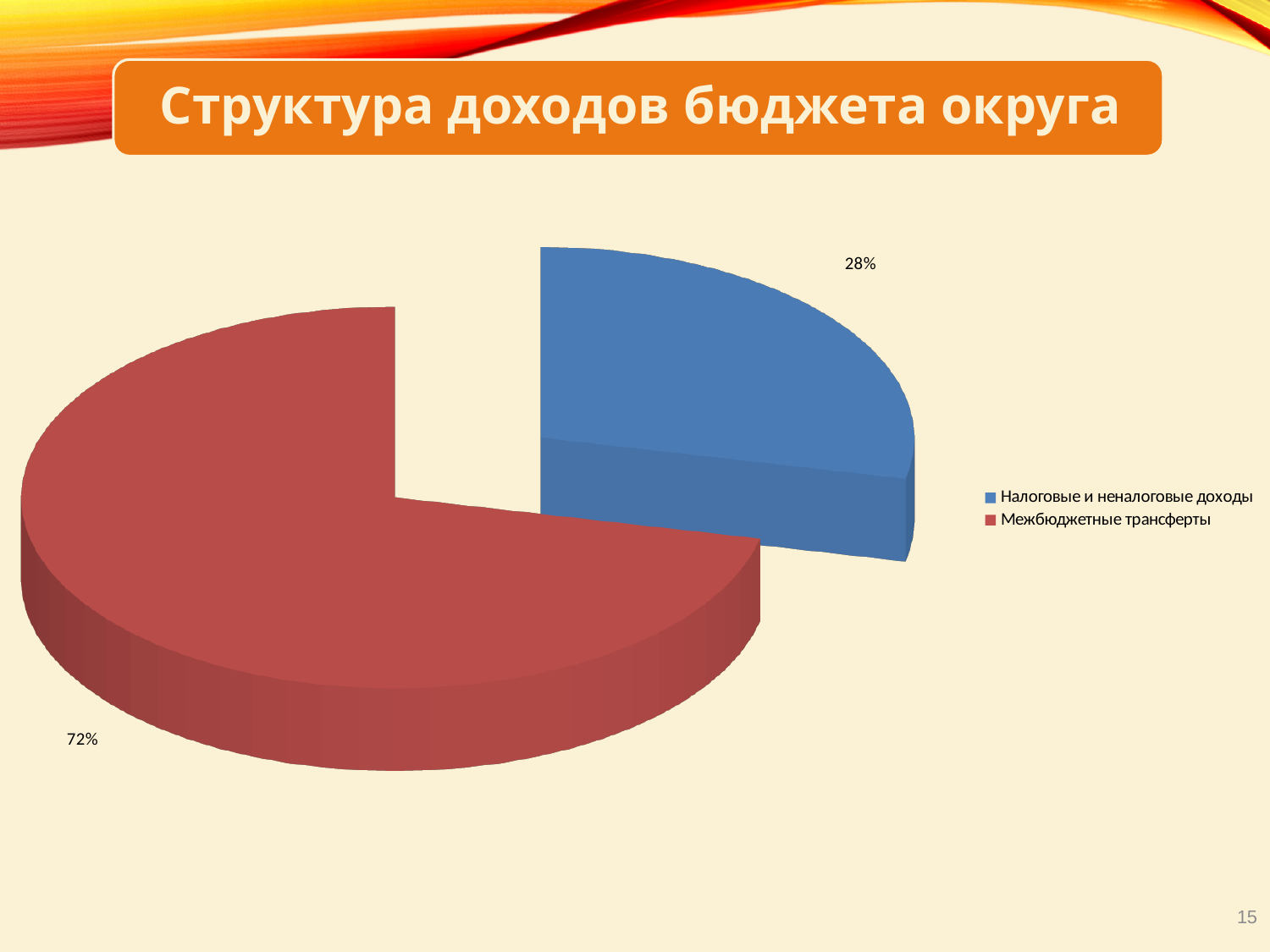
Which category has the largest slice of the pie? Межбюджетные трансферты What is the difference in percentage points between Межбюджетные трансферты and Налоговые и неналоговые доходы? 44 What is the title of the slide? Структура доходов бюджета округа What share of the pie does Налоговые и неналоговые доходы represent? 28% Which is larger: the slice for Налоговые и неналоговые доходы or the slice for Межбюджетные трансферты? Межбюджетные трансферты Which category has the smallest slice of the pie? Налоговые и неналоговые доходы How many slices does the pie chart have? 2 What colour is the slice for Межбюджетные трансферты? Red What kind of chart is shown on the slide? Pie chart What share of the pie does Межбюджетные трансферты represent? 72%